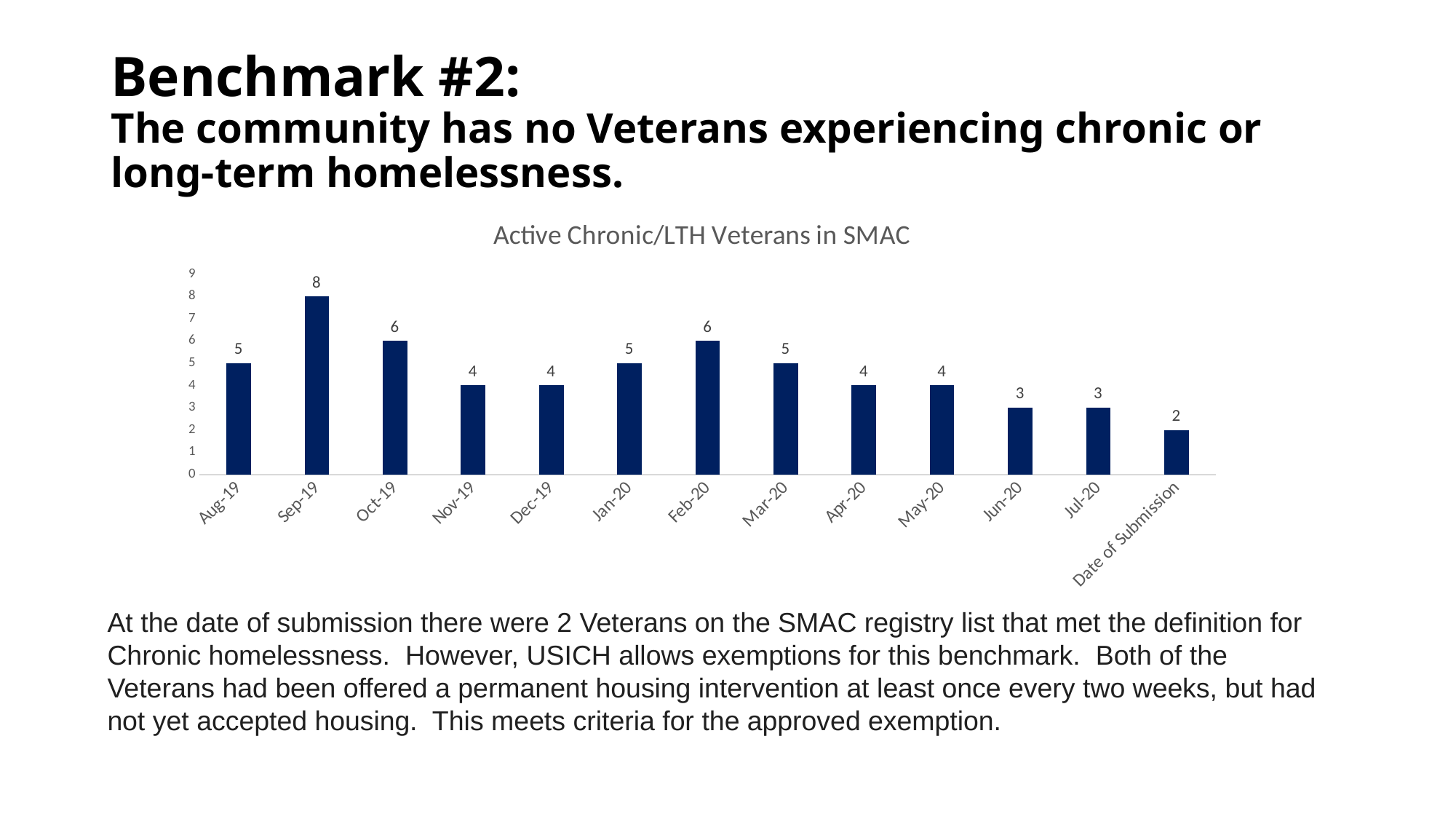
What is the title of the chart? Active Chronic/LTH Veterans in SMAC What kind of chart is shown on the slide? bar chart Which category has the highest value? Sep-19 Do the values generally rise or fall from Feb-20 to Date of Submission? fall Is the value for Sep-19 greater or less than 7? greater Which category has the lowest value? Date of Submission What is the value for Sep-19? 8 How many categories are shown on the x axis? 13 What is the value for Feb-20? 6 What is the difference between the values for Sep-19 and Jul-20? 5 Which is larger, the value for Oct-19 or the value for Nov-19? Oct-19 What is the value for Date of Submission? 2